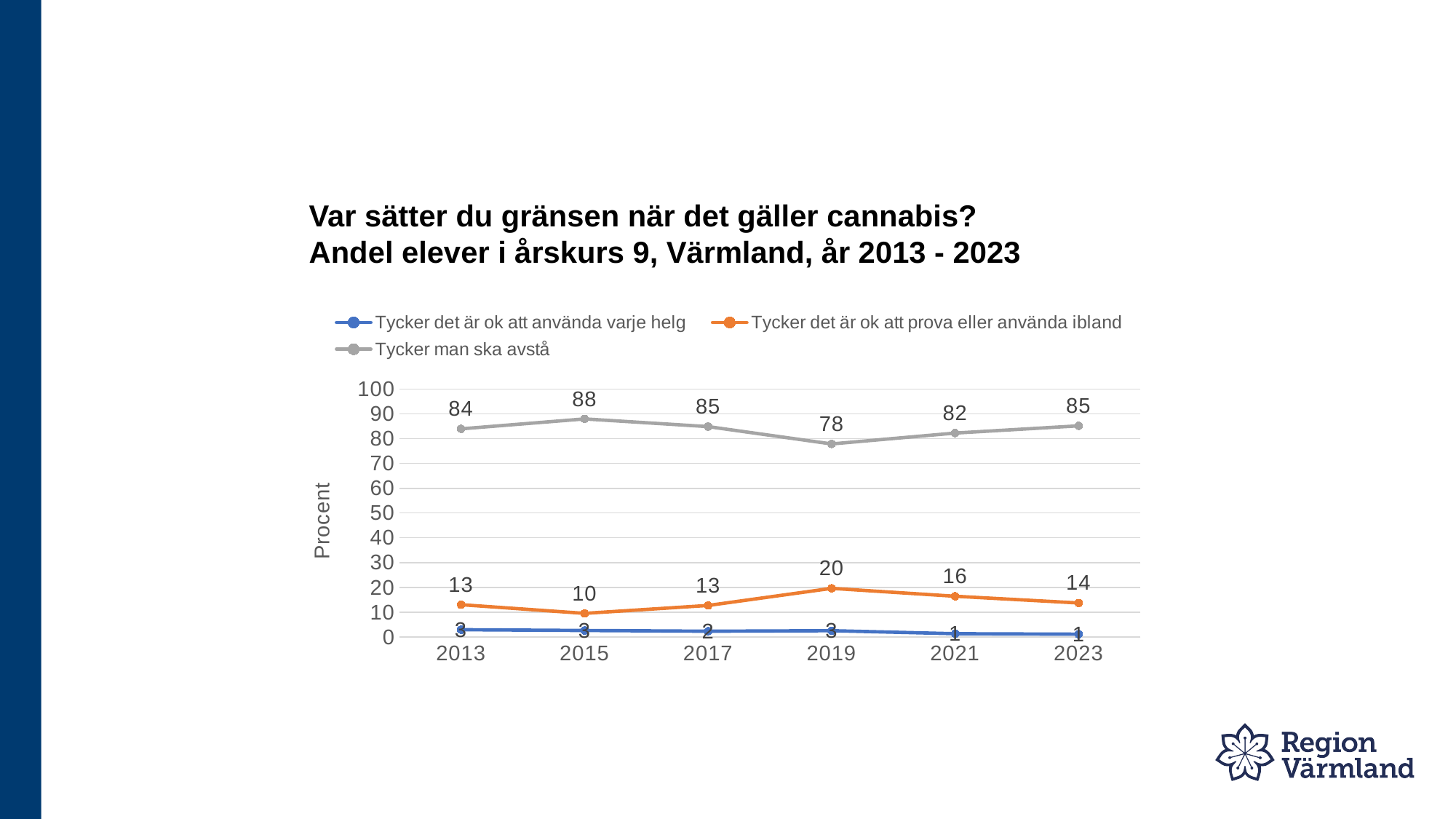
What is the difference between the 'Tycker man ska avstå' values in 2015 and 2019? 10 What is the value for 'Tycker man ska avstå' in 2019? 78 What is the label on the y axis? Procent How many series does the legend list? 3 Which is larger: 'Tycker det är ok att prova eller använda ibland' in 2019 or in 2023? 2019 In which year is 'Tycker man ska avstå' lowest? 2019 Is the value for 'Tycker det är ok att använda varje helg' in 2013 greater or less than 10? less In which year is 'Tycker det är ok att prova eller använda ibland' highest? 2019 What kind of chart is shown on the slide? line chart What is the value for 'Tycker det är ok att prova eller använda ibland' in 2021? 16 How many years are plotted along the x axis? 6 What is the value for 'Tycker man ska avstå' in 2015? 88